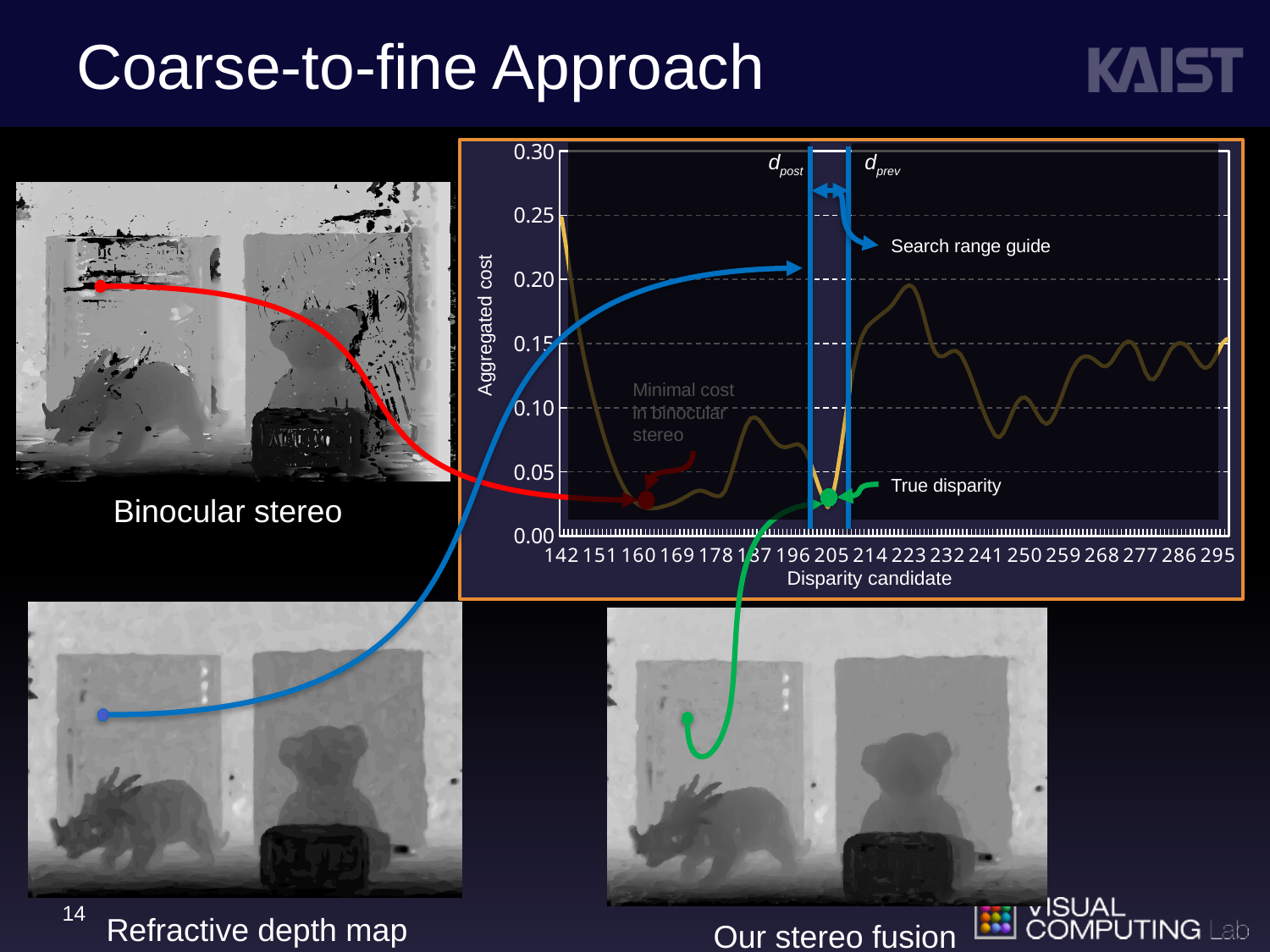
What is the label of the horizontal axis of the chart? Disparity candidate What is the first disparity candidate value shown on the horizontal axis? 142 Does the aggregated cost rise or fall as the disparity candidate goes from 142 to 160? fall What is the last disparity candidate value shown on the horizontal axis? 295 What is the highest value shown on the vertical axis of the chart? 0.30 What kind of chart is shown on the slide? line chart Which is larger, the aggregated cost at disparity candidate 142 or at disparity candidate 160? 142 How many tick labels are shown on the horizontal axis of the chart? 18 Is the aggregated cost at the point marked 'True disparity' greater or less than 0.10? less What is the label of the vertical axis of the chart? Aggregated cost Is the aggregated cost at disparity candidate 142 greater or less than 0.20? greater Is the aggregated cost at the point marked 'Minimal cost in binocular stereo' greater or less than 0.10? less